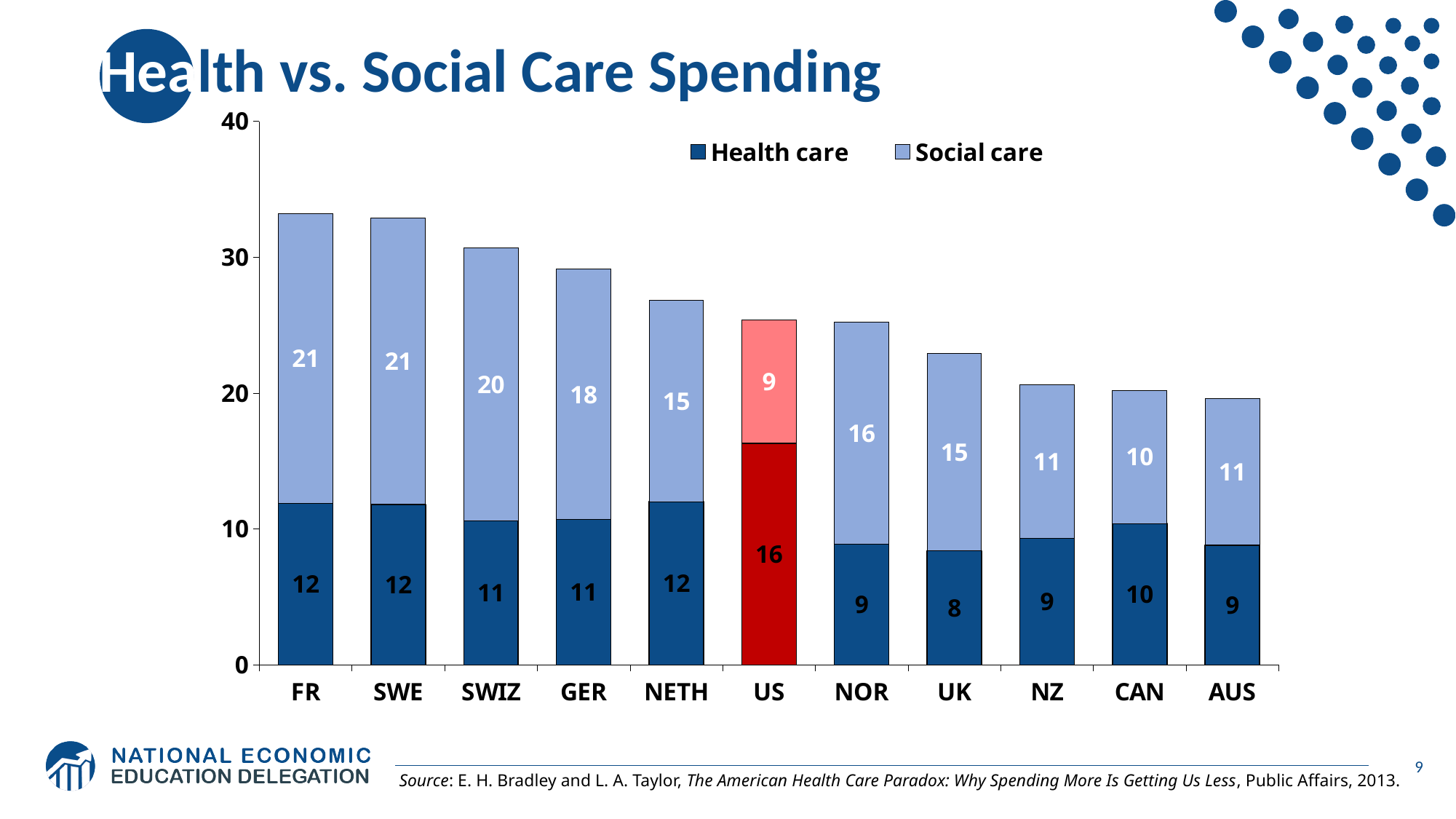
What kind of chart is shown on the slide? Bar chart Which country has the lowest Health care value? UK Which country has the highest Health care value? US Which country has the lowest Social care value? US What is the total of the stacked bar for the UK? 23 What is the difference between the Social care value for FR and the Social care value for the US? 12 How many countries are shown on the x axis? 11 Which country's bar is highlighted in red? US What is the Social care value for GER? 18 How many series does the legend list? 2 For NOR, which is larger: Health care or Social care? Social care What is the Health care value for the US? 16